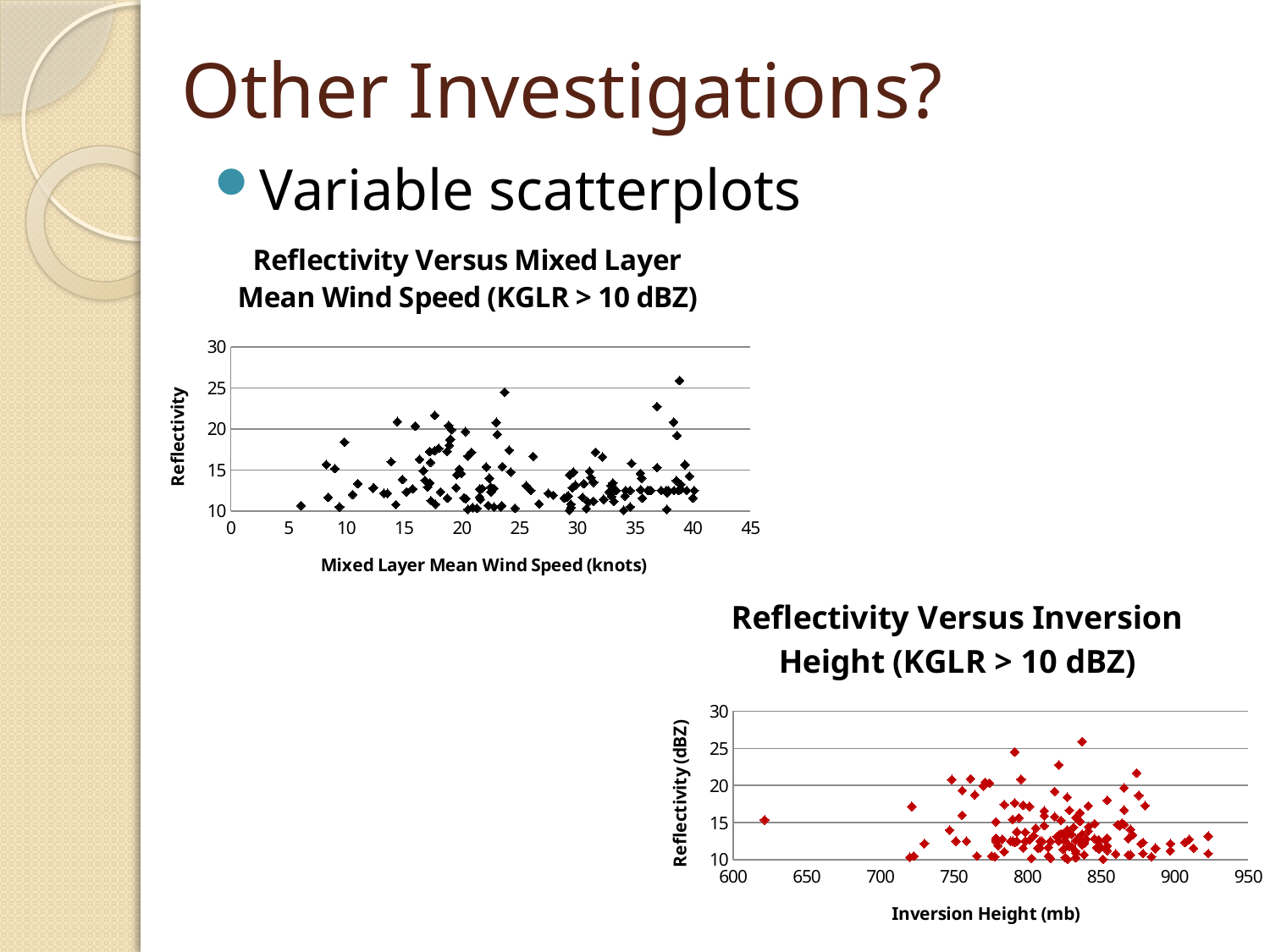
In the 'Reflectivity Versus Inversion Height' chart, is the inversion height of the rightmost point greater or less than 900? greater In the 'Reflectivity Versus Inversion Height' chart, what is the label of the y axis? Reflectivity (dBZ) In the 'Reflectivity Versus Mixed Layer Mean Wind Speed' chart, is the highest reflectivity value plotted greater or less than 20? greater In the 'Reflectivity Versus Mixed Layer Mean Wind Speed' chart, what is the label of the x axis? Mixed Layer Mean Wind Speed (knots) What kind of chart is the 'Reflectivity Versus Inversion Height (KGLR > 10 dBZ)' chart? Scatter plot What kind of chart is the 'Reflectivity Versus Mixed Layer Mean Wind Speed (KGLR > 10 dBZ)' chart? Scatter plot In the 'Reflectivity Versus Mixed Layer Mean Wind Speed' chart, is the wind speed of the rightmost point greater or less than 45? less In the 'Reflectivity Versus Mixed Layer Mean Wind Speed' chart, what is the maximum value shown on the y axis? 30